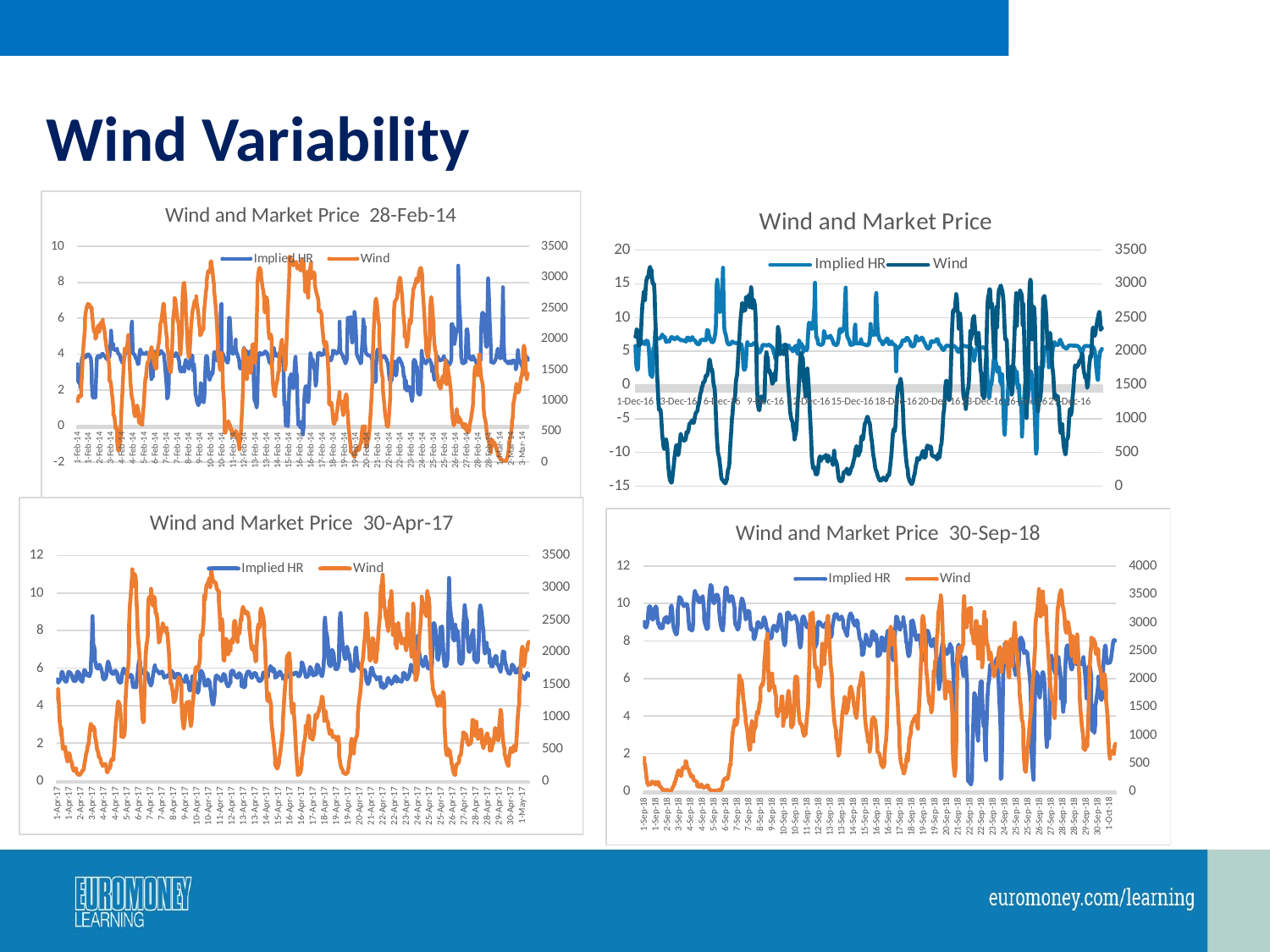
How many series does the legend list in the 'Wind and Market Price 30-Apr-17' chart? 2 What kind of chart is the 'Wind and Market Price 28-Feb-14' chart in the top-left of the slide? Line chart In the 'Wind and Market Price 30-Sep-18' chart, is the Wind value on 1-Sep-18 greater or less than 1000 on the right-hand axis? less What kind of chart is the 'Wind and Market Price 30-Sep-18' chart in the bottom-right of the slide? Line chart How many series does the legend list in the 'Wind and Market Price 28-Feb-14' chart? 2 What is the title of the bottom-left chart on the slide? Wind and Market Price 30-Apr-17 In the 'Wind and Market Price 30-Sep-18' chart, what are the two series named in the legend? Implied HR and Wind How many series does the legend list in the top-right 'Wind and Market Price' chart? 2